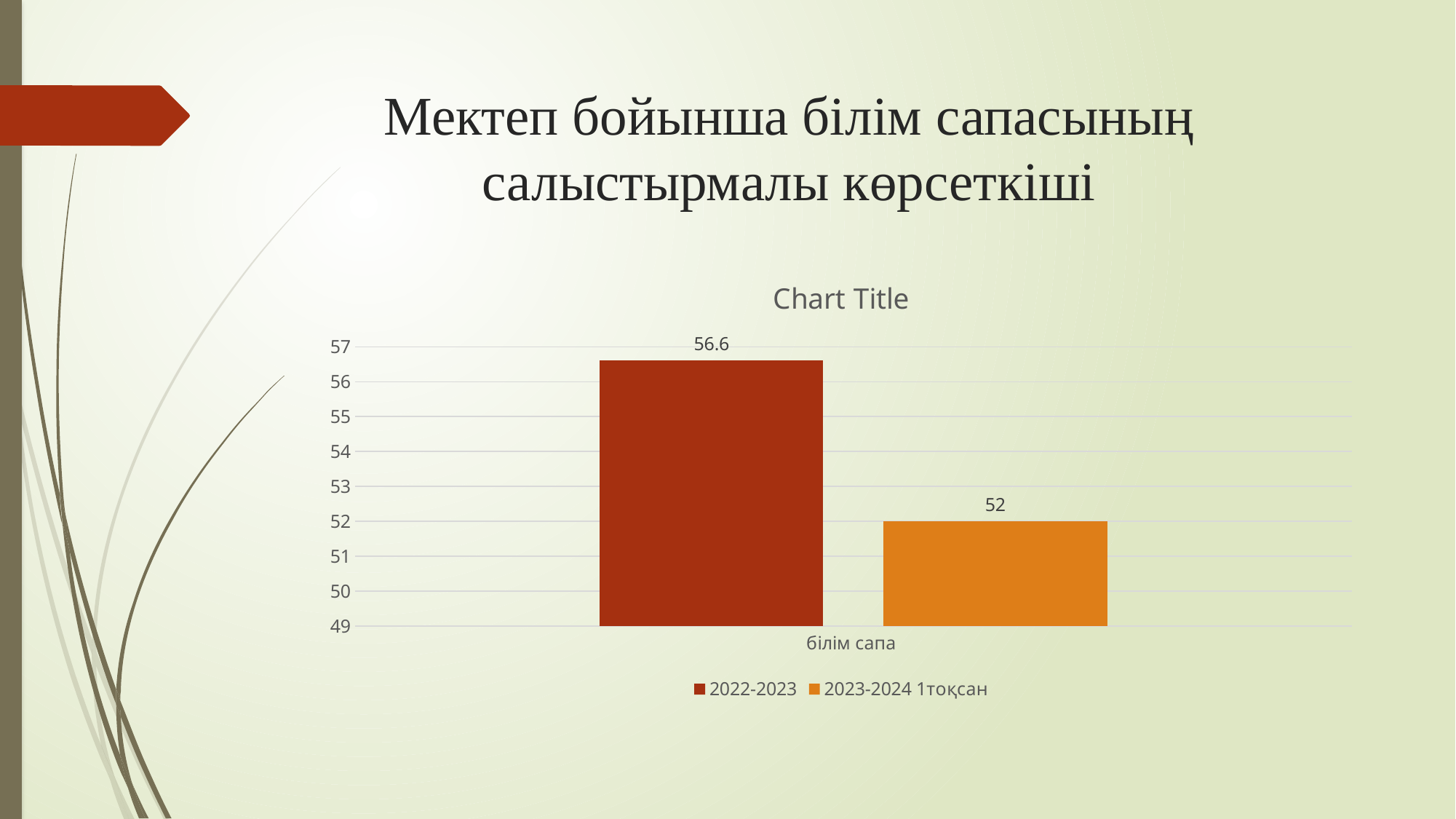
Which series has the higher value, 2022-2023 or 2023-2024 1тоқсан? 2022-2023 Is the value for 2023-2024 1тоқсан greater or less than 54? less How many categories are shown on the x axis? 1 Which series has the lowest value in the chart? 2023-2024 1тоқсан What is the title shown above the chart? Chart Title What is the value for the 2023-2024 1тоқсан series in the chart? 52 What is the difference between the 2022-2023 value and the 2023-2024 1тоқсан value? 4.6 What kind of chart is shown on the slide? Bar chart What is the category label on the x axis? білім сапа Is the value for 2022-2023 greater or less than 55? greater What is the value for the 2022-2023 series in the chart? 56.6 How many series does the legend list? 2